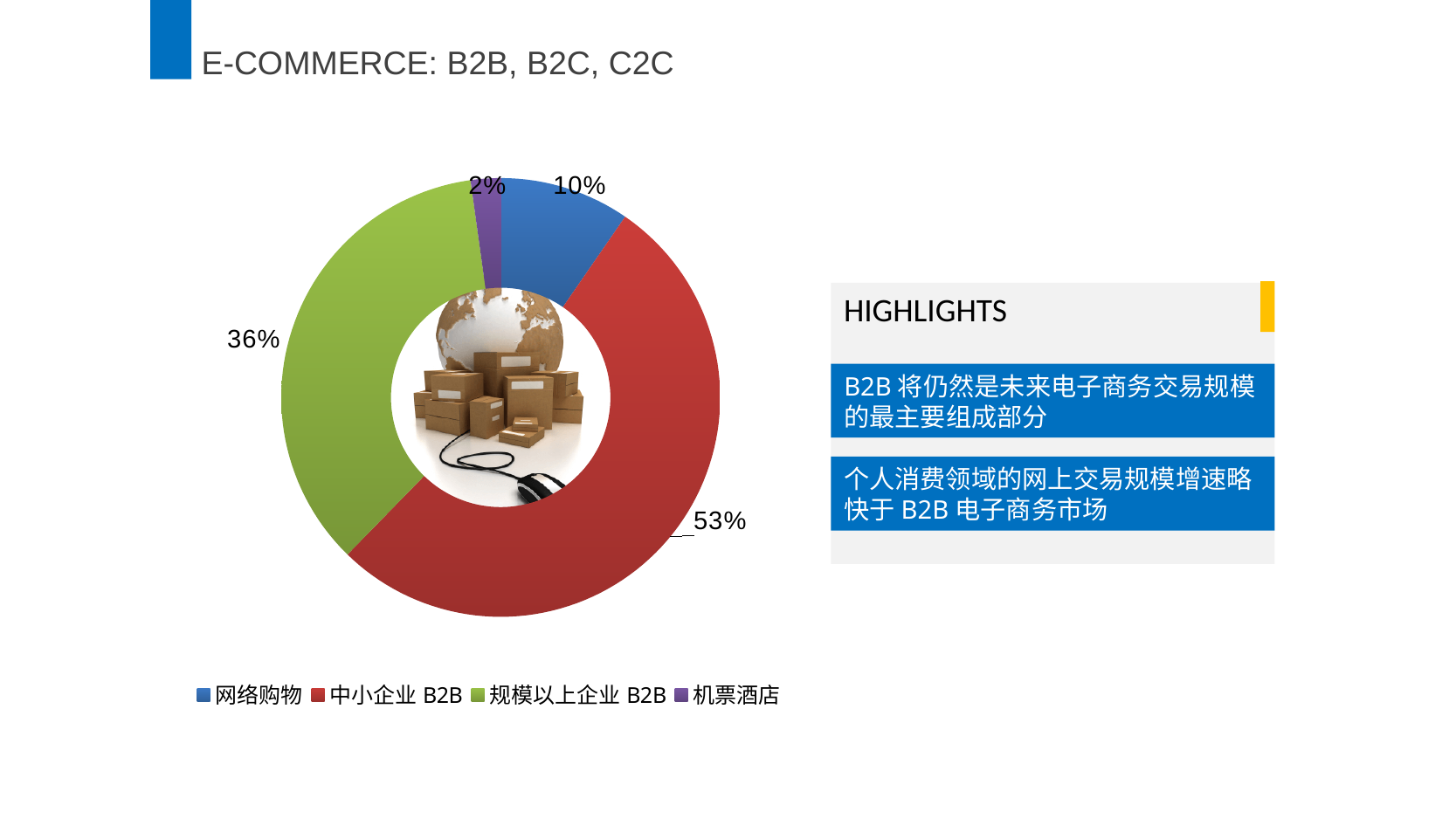
What is the combined share of the two B2B categories (中小企业 B2B and 规模以上企业 B2B)? 89% What share of the doughnut chart does 中小企业 B2B account for? 53% Which category has the smallest share in the doughnut chart? 机票酒店 Which has a larger share, 网络购物 or 机票酒店? 网络购物 How many categories are shown in the doughnut chart? 4 What share of the doughnut chart does 网络购物 account for? 10% What share of the doughnut chart does 规模以上企业 B2B account for? 36% What colour represents 规模以上企业 B2B in the chart? Green What type of chart is shown on the slide? Doughnut (pie) chart What is the difference in percentage points between the shares of 中小企业 B2B and 规模以上企业 B2B? 17 What share of the doughnut chart does 机票酒店 account for? 2% Which category has the largest share in the doughnut chart? 中小企业 B2B